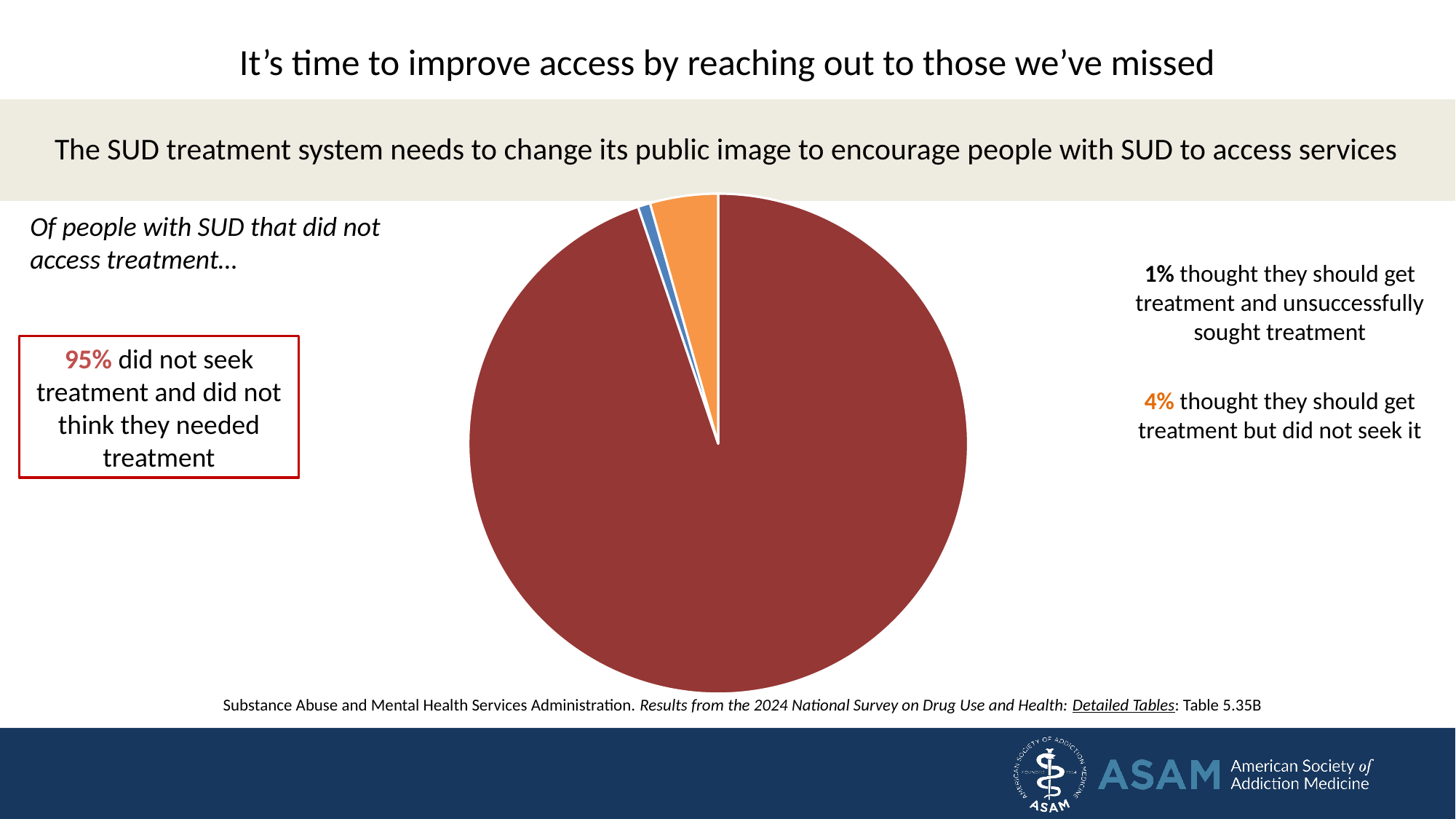
What kind of chart is shown on the slide? Pie chart What percentage of people with SUD that did not access treatment did not seek treatment and did not think they needed treatment? 95% What percentage thought they should get treatment but did not seek it? 4% Which group makes up the smallest slice of the pie chart? Thought they should get treatment and unsuccessfully sought treatment What is the difference in percentage points between those who did not think they needed treatment and those who thought they should get treatment but did not seek it? 91 Which is larger: the share that thought they should get treatment but did not seek it, or the share that unsuccessfully sought treatment? Thought they should get treatment but did not seek it What colour is the slice representing the 95% who did not seek treatment and did not think they needed it? Dark red What is the combined share of people who thought they should get treatment (whether or not they sought it)? 5% How many slices does the pie chart have? 3 Which group makes up the largest slice of the pie chart? Did not seek treatment and did not think they needed treatment What colour is the slice representing the 4% who thought they should get treatment but did not seek it? Orange What percentage thought they should get treatment and unsuccessfully sought treatment? 1%